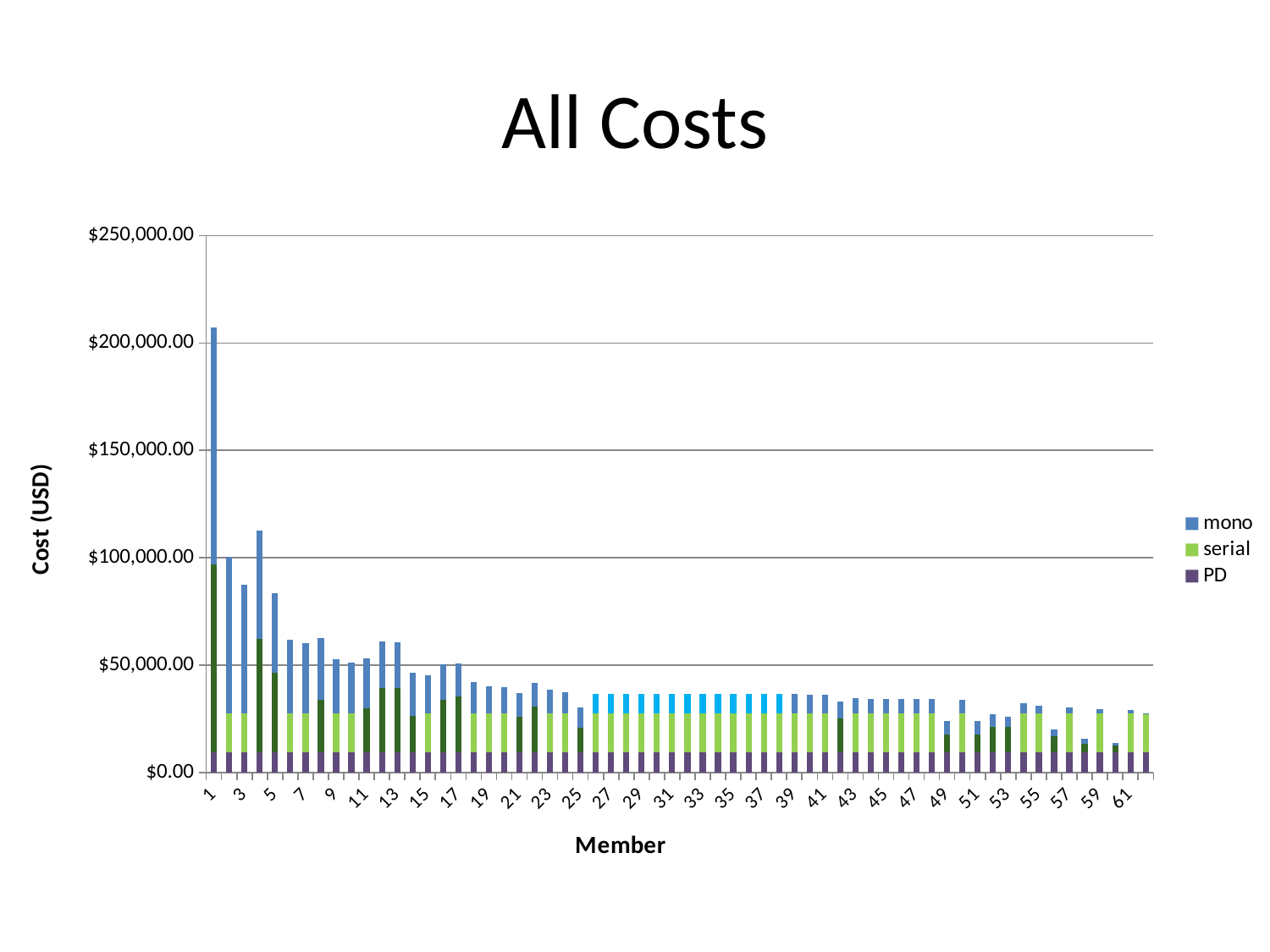
Is the total cost for member 3 greater or less than $100,000.00? less What are the series names listed in the legend? mono, serial, PD Is the total cost for member 1 greater or less than $200,000.00? greater What is the label of the y axis? Cost (USD) How many series does the legend list? 3 Do the total costs generally rise or fall as the member number increases along the x axis? Fall What kind of chart is shown on the slide? Stacked bar chart Is the total cost for member 50 greater or less than $50,000.00? less Which member has the highest total cost? 1 Which has the larger total cost, member 1 or member 4? Member 1 What is the title of the chart? All Costs